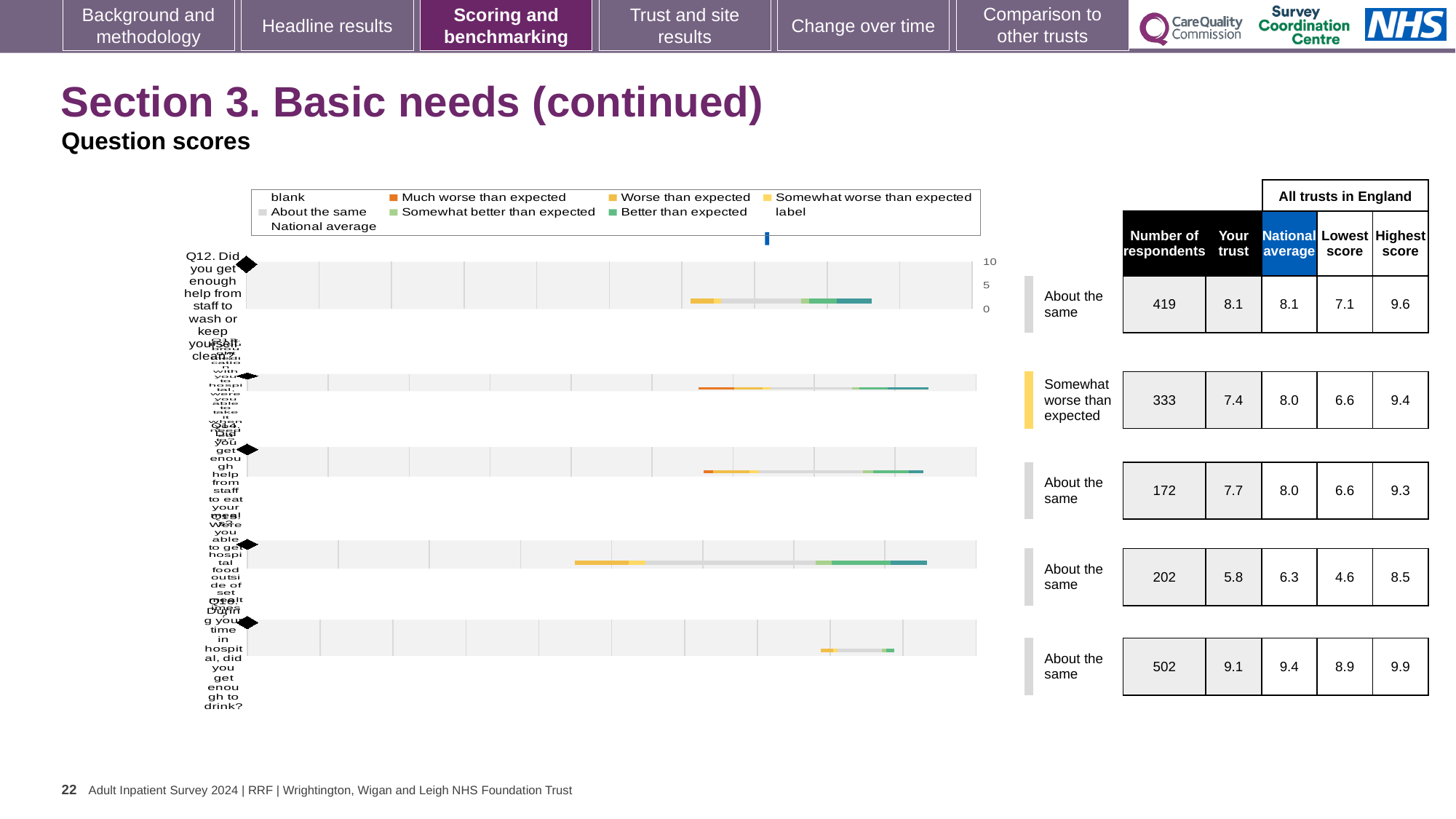
For Q12 in the table beside the chart, what is the difference between the highest score (9.6) and the lowest score (7.1)? 2.5 According to the table beside the chart, what is the 'Your trust' score for Q12 (help from staff to wash or keep yourself clean)? 8.1 For the second row (Q13) in the table beside the chart, which is larger: the 'Your trust' score or the 'National average'? National average (8.0) For the bottom row (Q16) in the table beside the chart, what is the 'National average' score? 9.4 According to the table beside the chart, how many respondents answered Q12 (help from staff to wash or keep yourself clean)? 419 What kind of chart is shown on the slide? bar chart Which question is plotted in the top row of the chart? Q12. Did you get enough help from staff to wash or keep yourself clean? In the chart legend, what colour represents 'Much worse than expected'? orange Which row in the table beside the chart has the lowest 'Your trust' score? Q15 (hospital food outside of set meal times), 5.8 Which benchmark category is shown for the second row (Q13) of the chart? Somewhat worse than expected Which row in the table beside the chart has the highest 'Your trust' score? Q16 (did you get enough to drink?), 9.1 How many question rows (bars) are plotted in the chart? 5